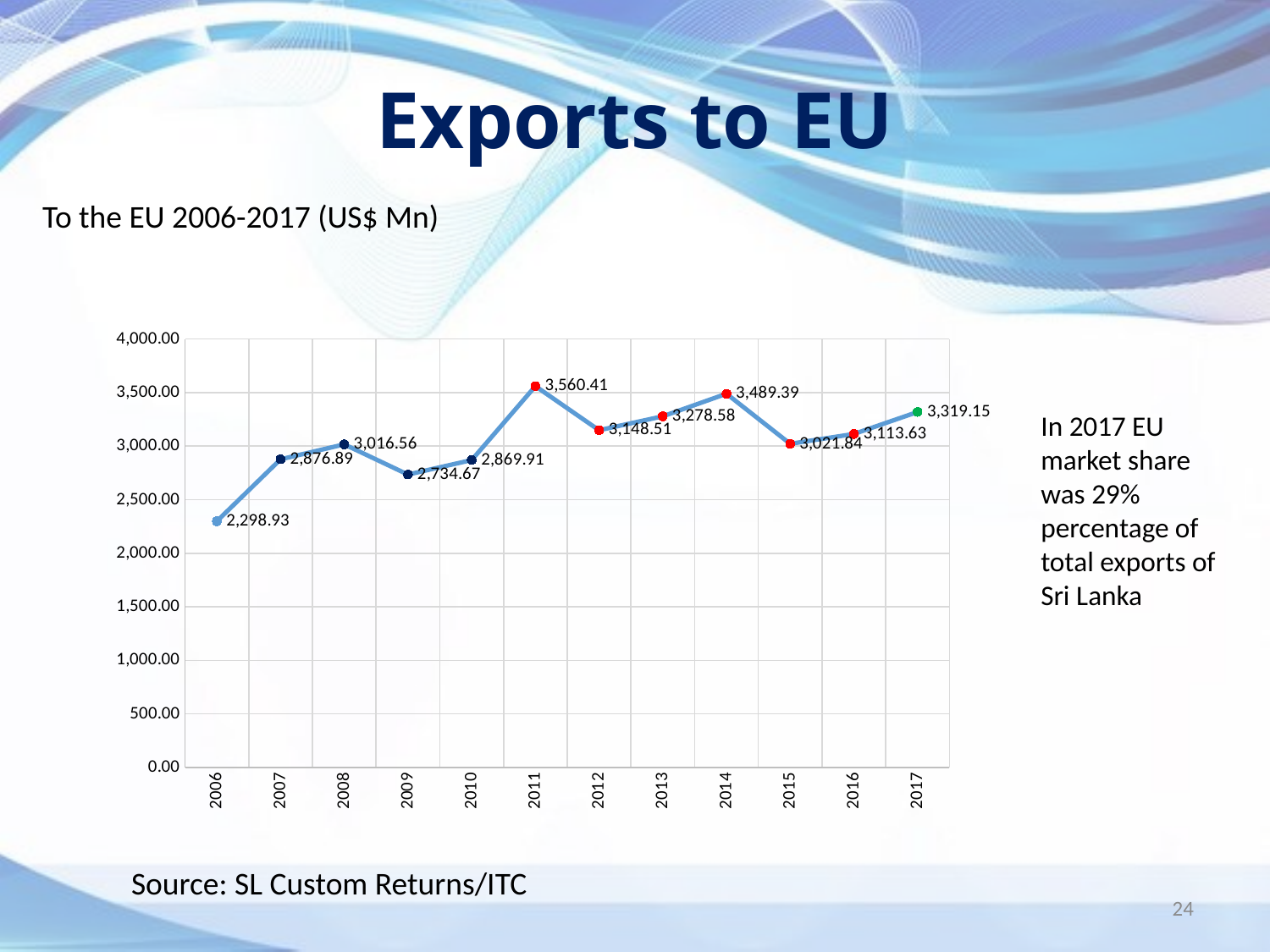
Which year had the highest exports to the EU? 2011 What was the value of exports to the EU in 2017? 3,319.15 Which year had higher exports to the EU, 2014 or 2015? 2014 How many years are plotted on the chart? 12 What was the value of exports to the EU in 2006? 2,298.93 What was the value of exports to the EU in 2011? 3,560.41 What type of chart is shown on the slide? Line chart What is the difference between exports to the EU in 2011 and in 2006? 1,261.48 By how much did exports to the EU increase from 2016 to 2017? 205.52 Which year had the lowest exports to the EU? 2006 What was the value of exports to the EU in 2009? 2,734.67 Did exports to the EU rise or fall from 2014 to 2015? Fall